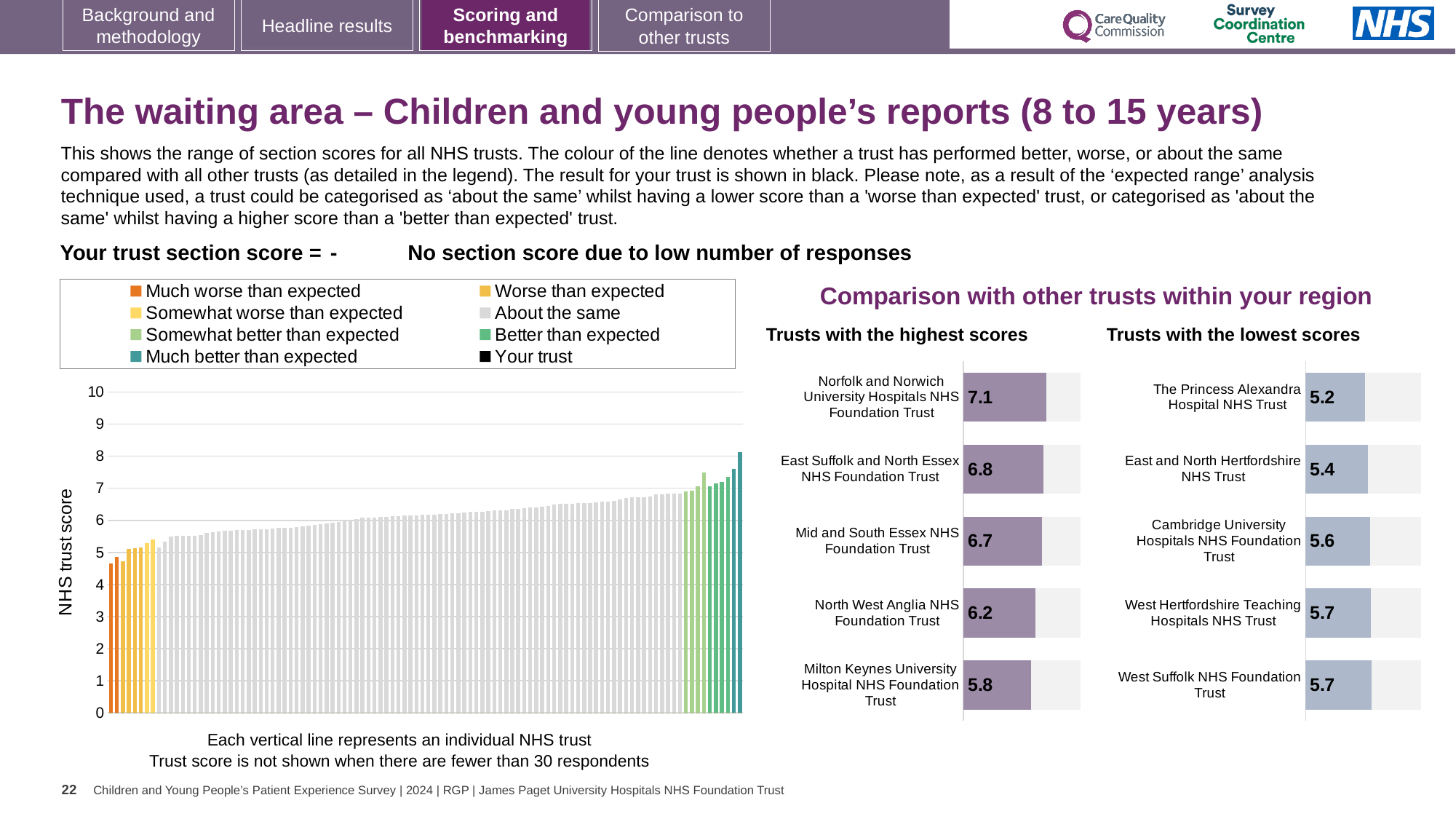
In the 'Trusts with the lowest scores' chart, what is the score for Cambridge University Hospitals NHS Foundation Trust? 5.6 In the 'Trusts with the lowest scores' chart, what is the score for The Princess Alexandra Hospital NHS Trust? 5.2 What type of chart is the large chart on the left showing NHS trust scores? Bar chart In the 'Trusts with the highest scores' chart, what is the difference between the scores of Norfolk and Norwich University Hospitals NHS Foundation Trust and Milton Keynes University Hospital NHS Foundation Trust? 1.3 In the 'Trusts with the highest scores' chart, what is the score for Norfolk and Norwich University Hospitals NHS Foundation Trust? 7.1 In the 'Trusts with the lowest scores' chart, which trust has the lowest score? The Princess Alexandra Hospital NHS Trust In the 'Trusts with the highest scores' chart, which trust has the highest score? Norfolk and Norwich University Hospitals NHS Foundation Trust How many trusts are listed in the 'Trusts with the lowest scores' chart? 5 In the 'Trusts with the highest scores' chart, which has the higher score: East Suffolk and North Essex NHS Foundation Trust or Mid and South Essex NHS Foundation Trust? East Suffolk and North Essex NHS Foundation Trust How many entries does the legend of the large chart on the left list? 8 In the 'Trusts with the highest scores' chart, what is the score for Milton Keynes University Hospital NHS Foundation Trust? 5.8 In the large chart on the left, is the value of the lowest bar greater or less than 5? less